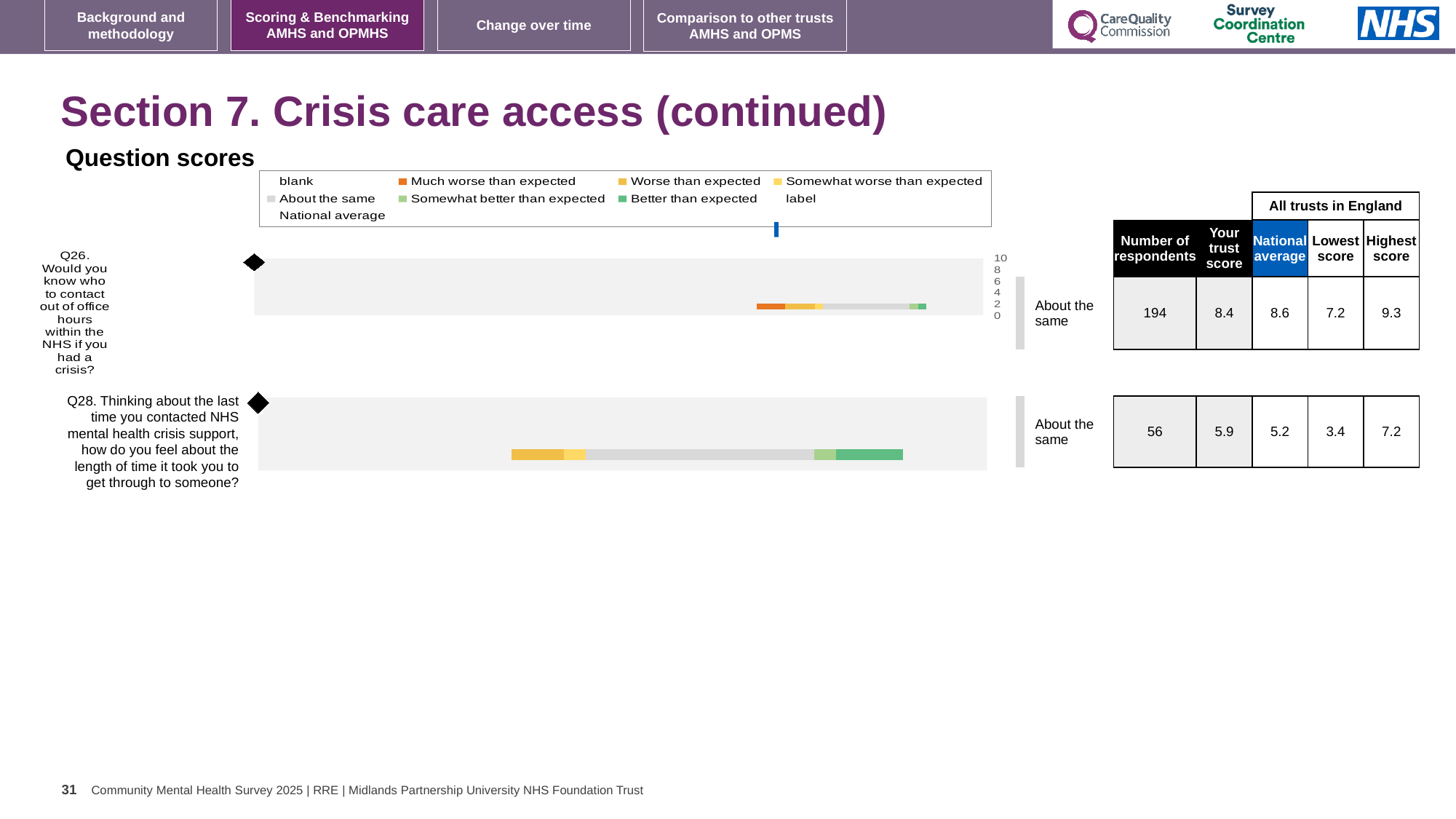
For Q28, what is the difference between the trust's score and the national average? 0.7 In the table beside the chart, what is the trust's score for Q26? 8.4 What benchmark category is shown next to the bar for Q26? About the same In the table beside the chart, what is the national average for Q26? 8.6 What benchmark category is shown next to the bar for Q28? About the same What kind of chart is used to show the question scores for Q26 and Q28? bar chart What is the highest tick value shown on the chart's score axis? 10 In the table beside the chart, how many respondents answered Q28? 56 In the chart legend, what colour represents 'Better than expected'? green In the chart legend, what colour represents 'Much worse than expected'? orange How many questions are plotted in the question scores chart? 2 For Q28, which is larger: the trust's score or the national average? the trust's score